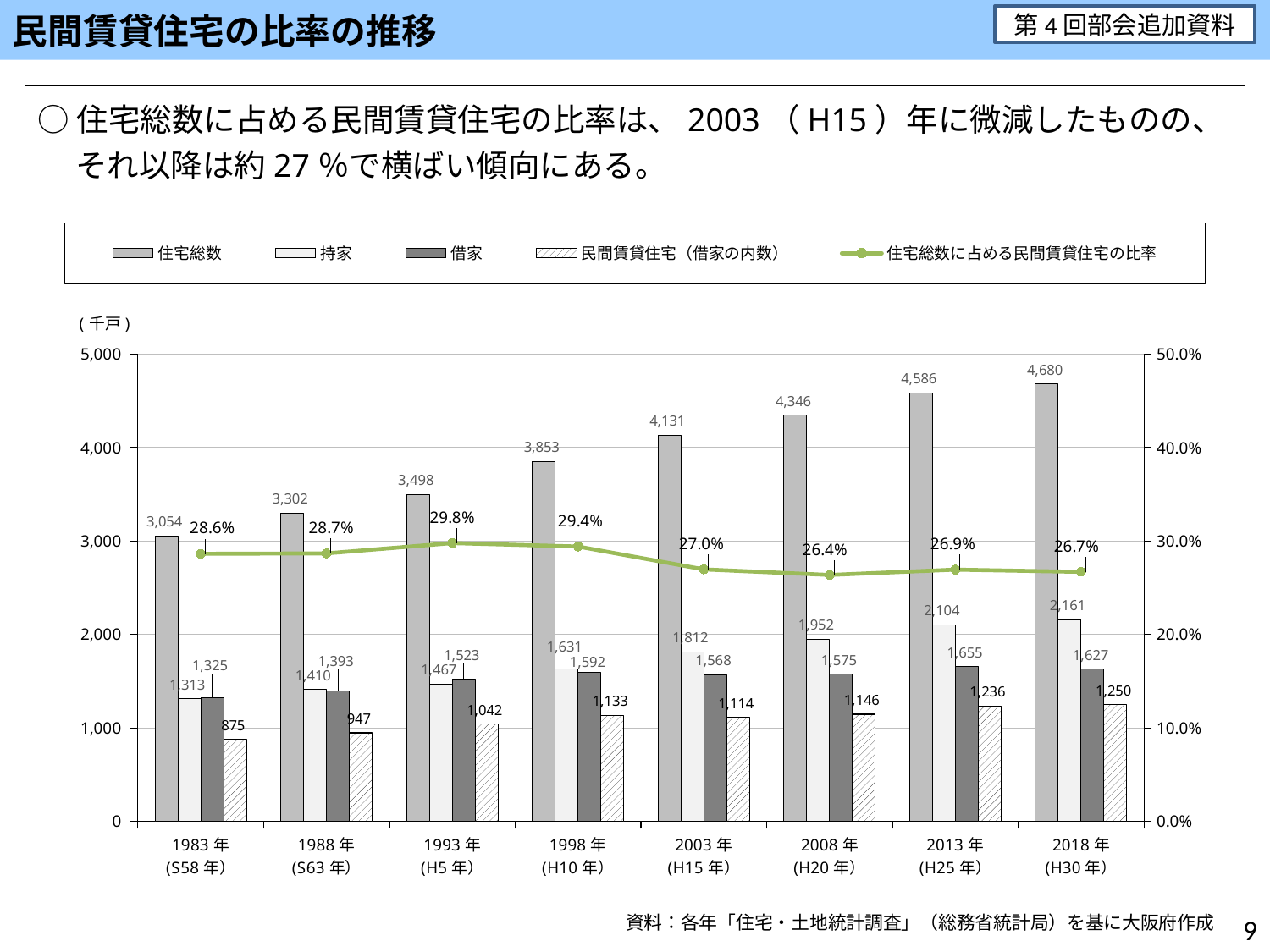
What is the value of 持家 for 2013年 (H25年)? 2,104 In which year is the 住宅総数に占める民間賃貸住宅の比率 lowest? 2008年 (H20年) What is the difference between 住宅総数 in 2018年 (H30年) and 1983年 (S58年)? 1,626 What kind of chart is this? Combined bar and line chart Which is larger in 1998年 (H10年): 持家 or 借家? 持家 What is the value of 住宅総数 for 2018年 (H30年)? 4,680 How many series does the legend list? 5 Does 住宅総数 rise or fall from 1983年 to 2018年? Rise What is the 住宅総数に占める民間賃貸住宅の比率 for 2003年 (H15年)? 27.0% What is the value of 民間賃貸住宅（借家の内数） for 1983年 (S58年)? 875 In which year is the 住宅総数に占める民間賃貸住宅の比率 highest? 1993年 (H5年) How many years are shown on the x axis? 8